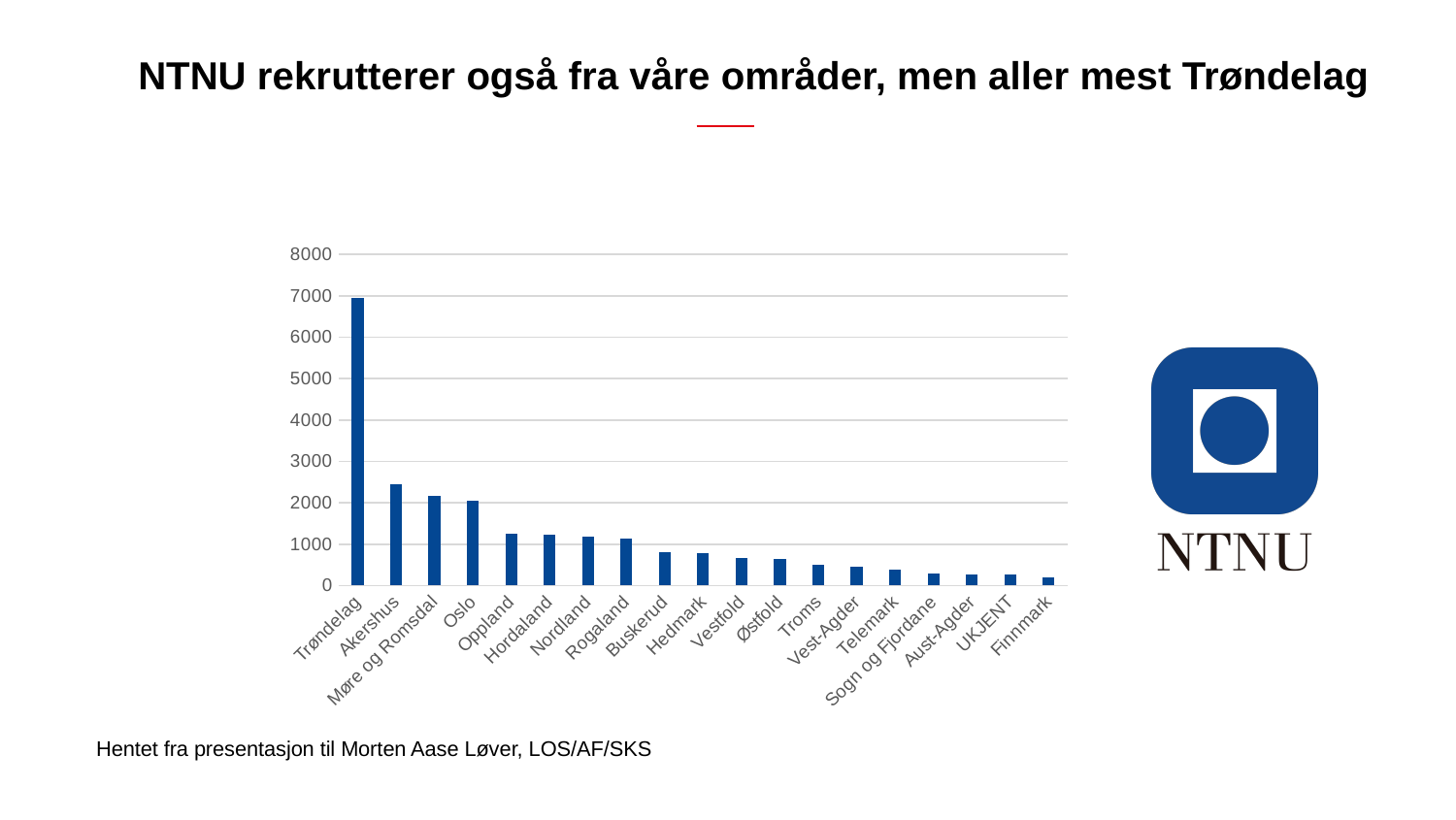
Is the value for Buskerud greater or less than 1000? less Is the value for Akershus greater or less than 2000? greater Is the value for Finnmark greater or less than 1000? less Do the values rise or fall moving from left to right along the x axis? fall Which region has the lowest value in the chart? Finnmark Which has the larger value, Akershus or Oslo? Akershus What kind of chart is shown on the slide? bar chart Which region has the highest value in the chart? Trøndelag What is the title of the slide containing the chart? NTNU rekrutterer også fra våre områder, men aller mest Trøndelag How many categories are shown along the x axis of the chart? 19